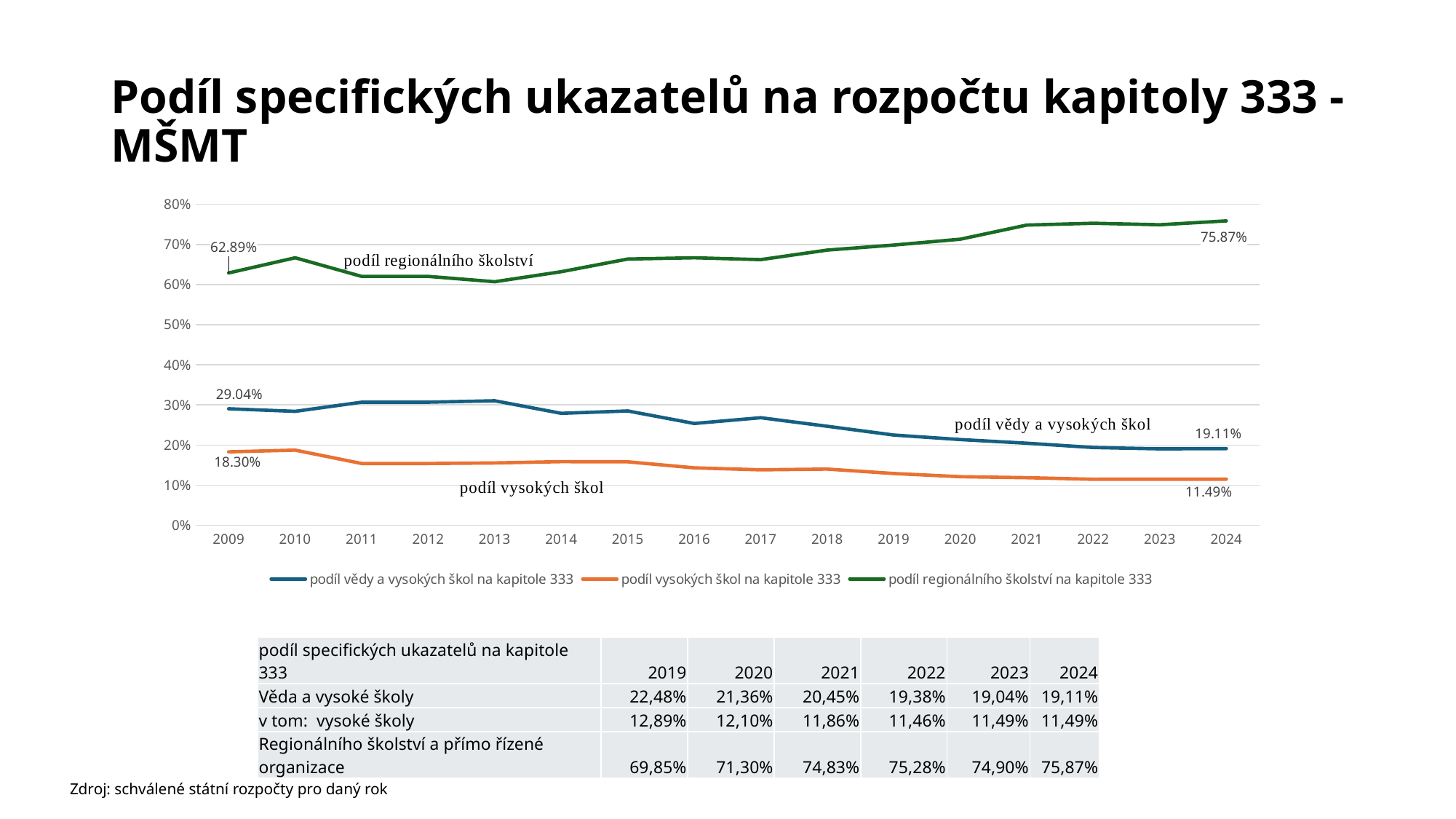
How many series does the chart legend list? 3 What is the value of 'podíl vědy a vysokých škol na kapitole 333' in 2009? 29.04% By how many percentage points did 'podíl vědy a vysokých škol na kapitole 333' fall from 2009 to 2024? 9.93 percentage points How many years are plotted along the x axis of the chart? 16 What is the value of 'podíl regionálního školství na kapitole 333' in 2009? 62.89% What is the value of 'podíl vysokých škol na kapitole 333' in 2024? 11.49% Which series has the highest value in 2024? podíl regionálního školství na kapitole 333 By how many percentage points did 'podíl regionálního školství na kapitole 333' change between 2009 and 2024? 12.98 percentage points What type of chart is shown on the slide? line chart Does 'podíl vědy a vysokých škol na kapitole 333' generally rise or fall from 2009 to 2024? fall Is the value for 'podíl regionálního školství na kapitole 333' in 2013 greater or less than 70%? less What is the value of 'podíl regionálního školství na kapitole 333' in 2024? 75.87%